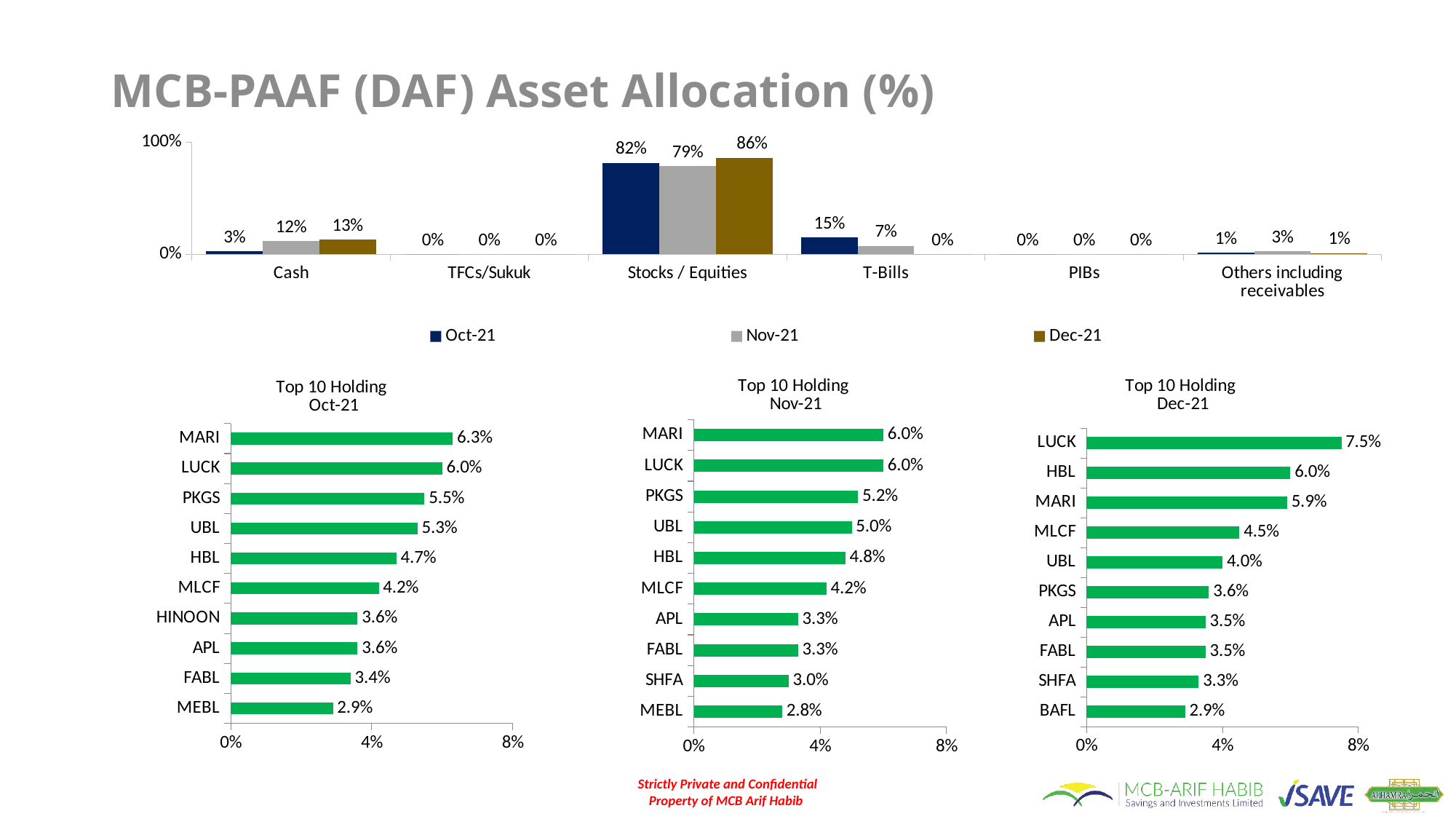
In the Top 10 Holding Dec-21 chart, which holding has the highest value? LUCK In the Top 10 Holding Oct-21 chart, what is the value for PKGS? 5.5% In the asset allocation chart at the top, how many categories are shown on the x axis? 6 In the Top 10 Holding Dec-21 chart, what is the difference between the values for LUCK and HBL? 1.5% In the asset allocation chart at the top, what is the value for T-Bills in Oct-21? 15% In the asset allocation chart at the top, what is the value for Stocks / Equities in Dec-21? 86% What kind of chart is the Top 10 Holding Dec-21 chart? Bar chart In the asset allocation chart at the top, how many series does the legend list? 3 In the asset allocation chart at the top, which category has the highest value for Nov-21? Stocks / Equities In the asset allocation chart at the top, what is the difference between the Cash values for Dec-21 and Oct-21? 10% In the Top 10 Holding Oct-21 chart, which holding has the lowest value? MEBL In the Top 10 Holding Nov-21 chart, what is the value for HBL? 4.8%